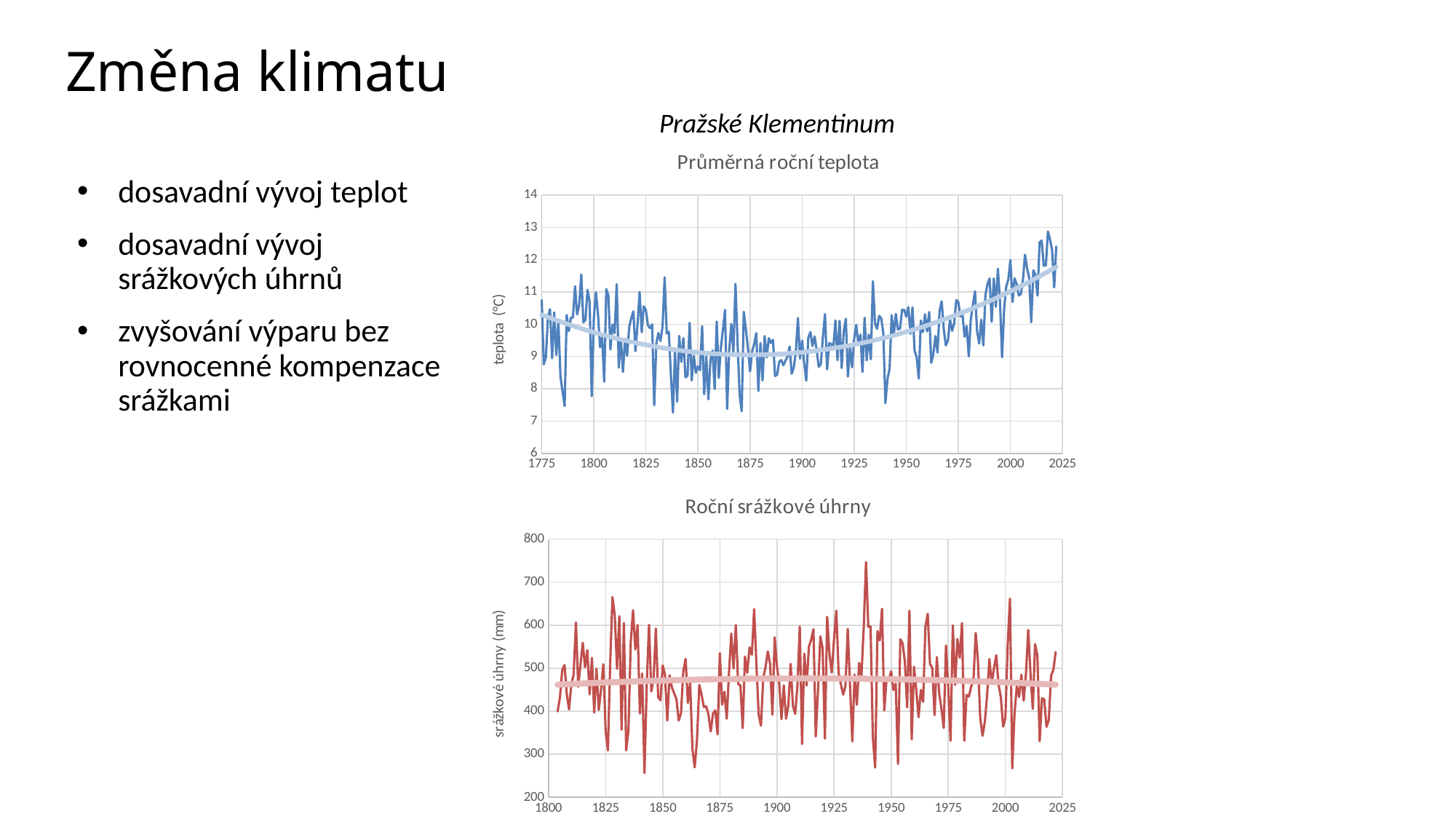
What is the y-axis label of the bottom chart "Roční srážkové úhrny"? srážkové úhrny (mm) In the bottom chart "Roční srážkové úhrny", does the smoothed trend line rise strongly, fall strongly, or stay roughly flat across the x axis? roughly flat What kind of chart is the bottom chart titled "Roční srážkové úhrny"? line chart In the bottom chart "Roční srážkové úhrny", is the highest plotted value greater or less than 700? greater In the top chart "Průměrná roční teplota", is the highest plotted temperature greater or less than 12? greater In the top chart "Průměrná roční teplota", is the lowest plotted temperature greater or less than 8? less What is the common heading shown above both charts on the slide? Pražské Klementinum In the top chart "Průměrná roční teplota", do the values generally rise or fall along the x axis from 1900 to 2025? rise What kind of chart is the top chart titled "Průměrná roční teplota"? line chart